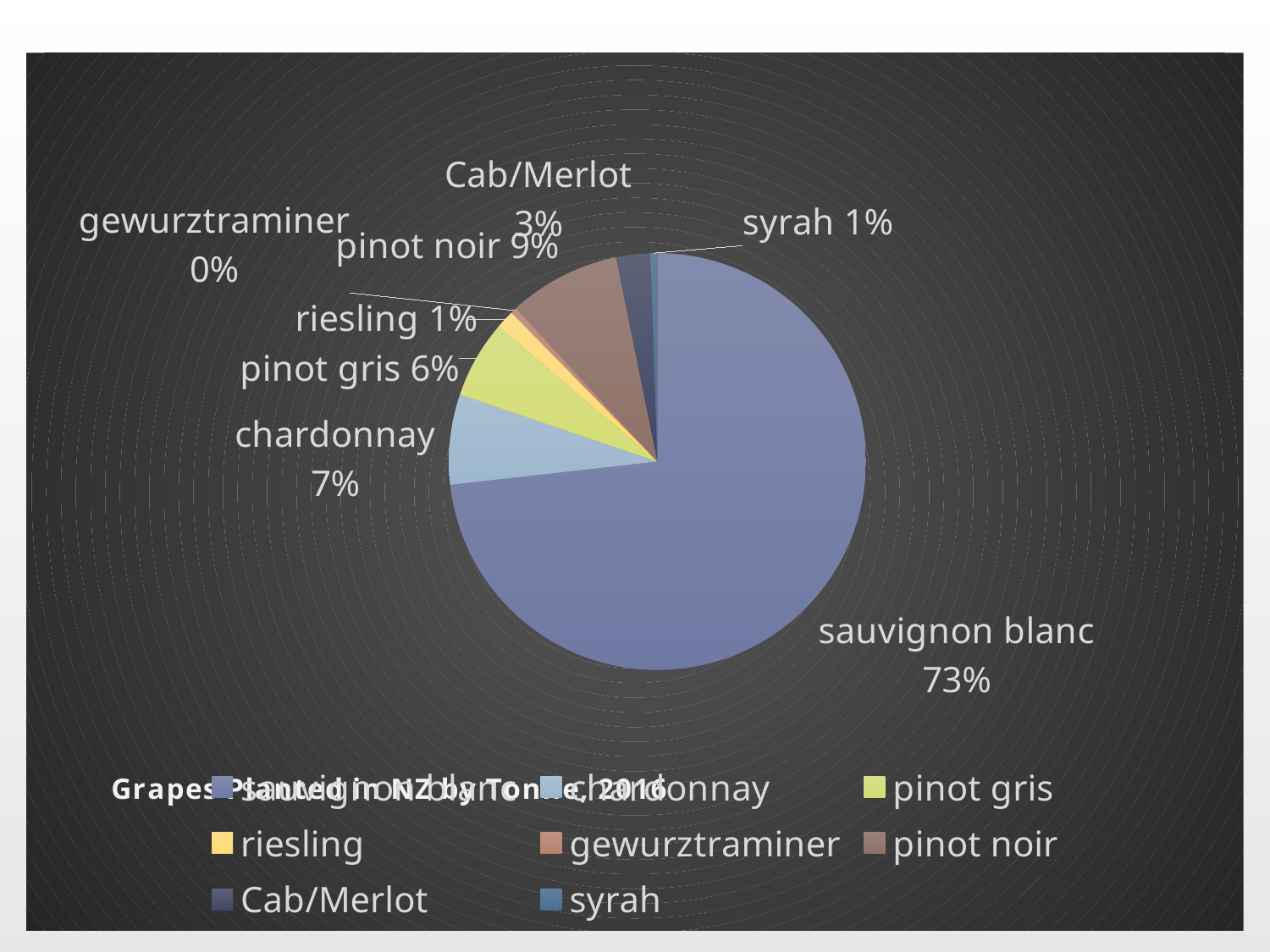
Which grape variety has the largest slice of the pie? sauvignon blanc What is the difference in percentage points between sauvignon blanc and pinot noir? 64 Which grape variety has the smallest slice of the pie? gewurztraminer What share of the pie does Cab/Merlot have? 3% What share of the pie does chardonnay have? 7% What type of chart is shown on the slide? pie chart What share of the pie does gewurztraminer have? 0% Which has a larger share, pinot noir or chardonnay? pinot noir How many grape varieties does the legend list? 8